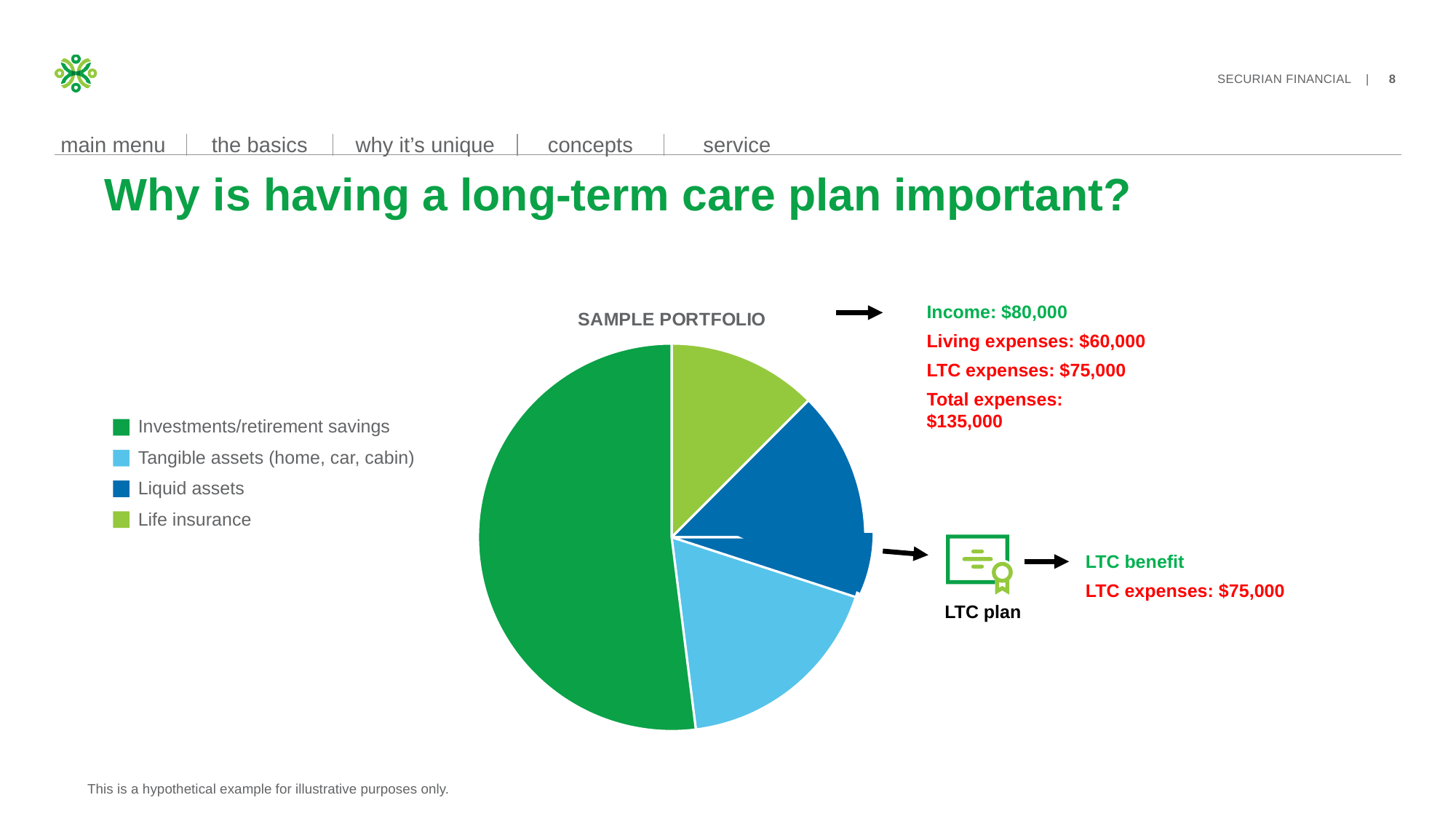
Which slice is larger: Investments/retirement savings or Tangible assets (home, car, cabin)? Investments/retirement savings What is the title of the pie chart? SAMPLE PORTFOLIO Which slice is larger: Tangible assets (home, car, cabin) or Life insurance? Tangible assets (home, car, cabin) What kind of chart is shown on the slide? pie chart Which legend category is shown in dark blue in the pie chart? Liquid assets How many entries does the legend of the pie chart list? 4 Which category has the largest slice in the pie chart? Investments/retirement savings Which slice is larger: Investments/retirement savings or Liquid assets? Investments/retirement savings